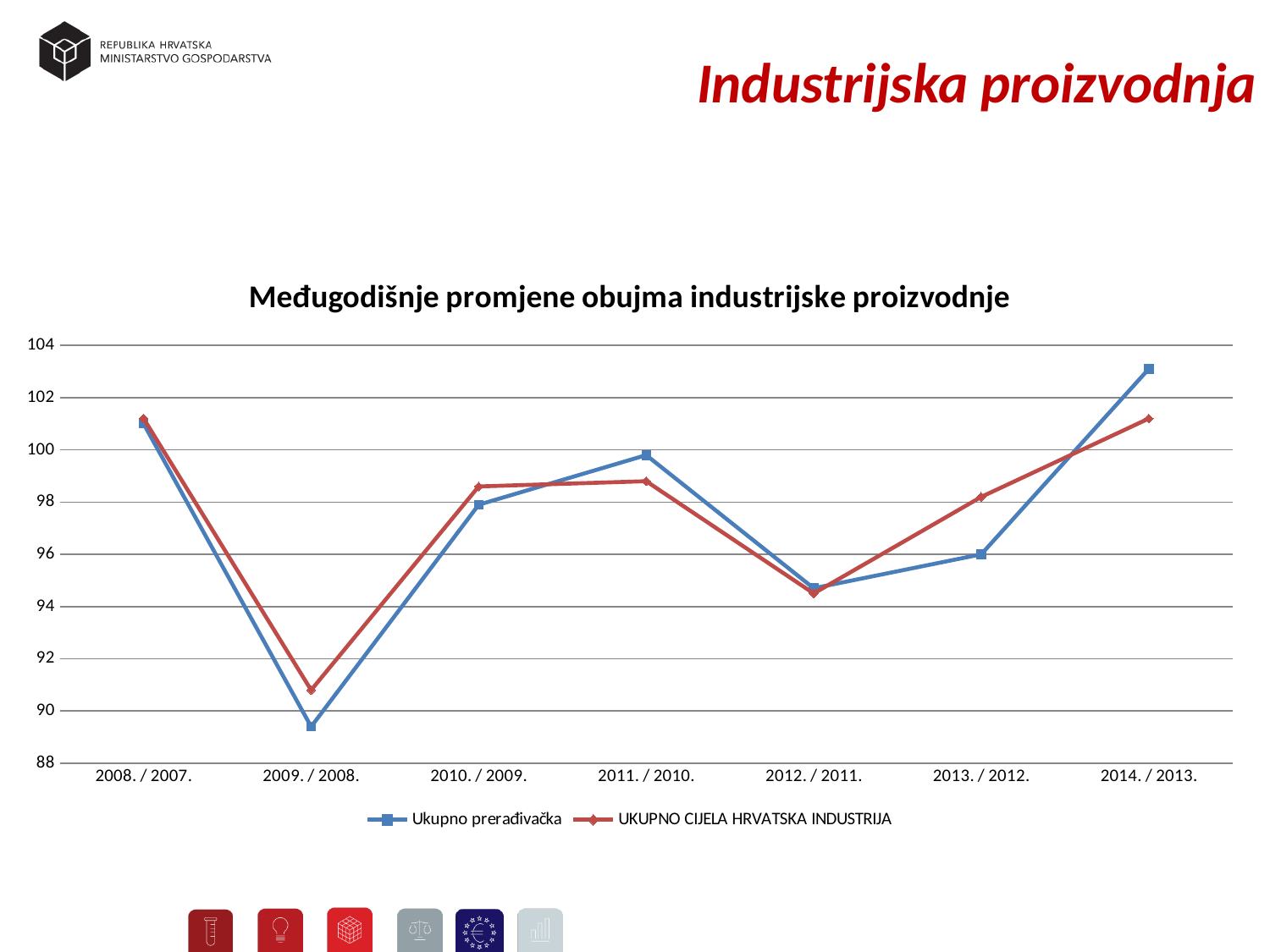
Is the value for UKUPNO CIJELA HRVATSKA INDUSTRIJA in 2009. / 2008. greater or less than 90? greater In 2014. / 2013., which series has the higher value, Ukupno prerađivačka or UKUPNO CIJELA HRVATSKA INDUSTRIJA? Ukupno prerađivačka In 2013. / 2012., which series has the higher value, Ukupno prerađivačka or UKUPNO CIJELA HRVATSKA INDUSTRIJA? UKUPNO CIJELA HRVATSKA INDUSTRIJA In which period is the value for Ukupno prerađivačka highest? 2014. / 2013. What is the title of the chart? Međugodišnje promjene obujma industrijske proizvodnje How many periods are shown on the x axis? 7 What kind of chart is shown on the slide? line chart How many series does the legend list? 2 Is the value for Ukupno prerađivačka in 2014. / 2013. greater or less than 102? greater Is the value for Ukupno prerađivačka in 2009. / 2008. greater or less than 90? less Does the value for Ukupno prerađivačka rise or fall from 2012. / 2011. to 2014. / 2013.? rise In which period is the value for Ukupno prerađivačka lowest? 2009. / 2008.